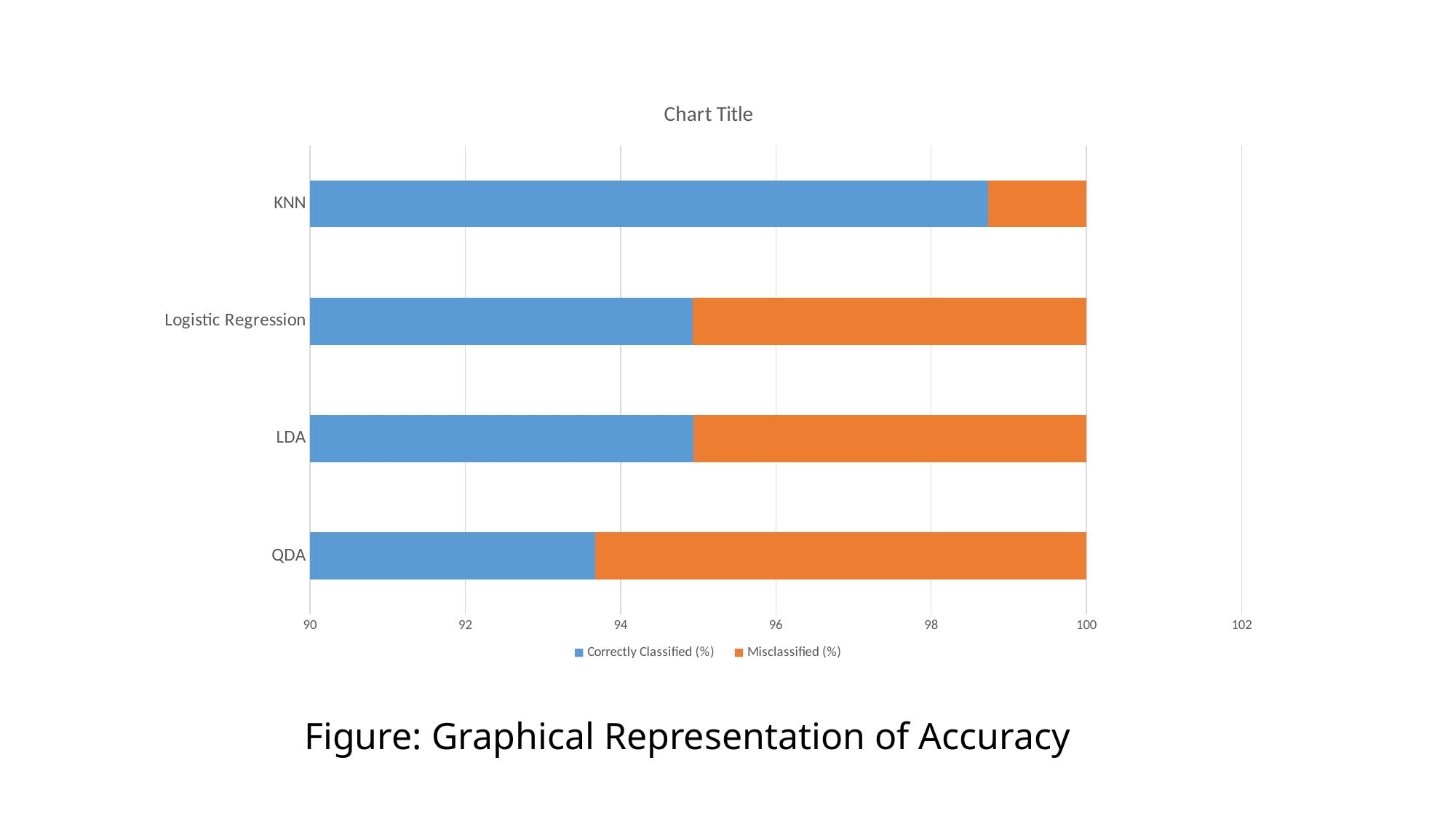
Is the Correctly Classified (%) value for LDA greater or less than 94? greater Which classifier has the highest Correctly Classified (%) value? KNN Is the Correctly Classified (%) value for KNN greater or less than 98? greater How many series does the legend list? 2 Is the Correctly Classified (%) value for QDA greater or less than 94? less Which has a larger Correctly Classified (%) value, KNN or QDA? KNN Which series is shown in orange in the legend? Misclassified (%) Which classifier has the lowest Correctly Classified (%) value? QDA What kind of chart is shown on the slide? Stacked bar chart How many categories (classifiers) are plotted on the chart? 4 What is the total of the stacked bar for KNN? 100 Which classifier has the smallest Misclassified (%) segment? KNN